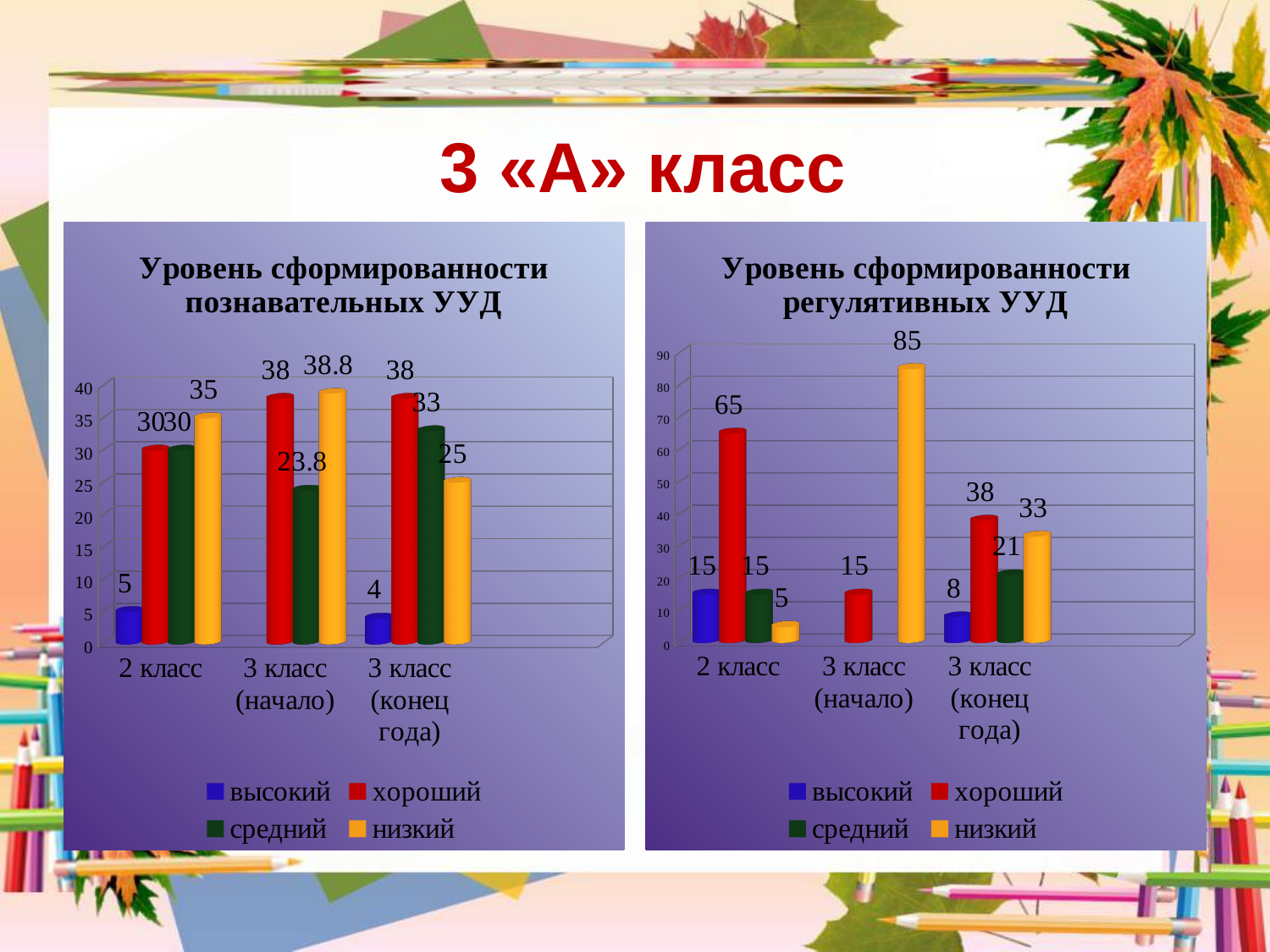
What kind of chart is the chart titled "Уровень сформированности познавательных УУД"? bar chart On the chart titled "Уровень сформированности регулятивных УУД", what is the value for хороший in 2 класс? 65 On the chart titled "Уровень сформированности регулятивных УУД", what is the value for низкий in 3 класс (начало)? 85 On the chart titled "Уровень сформированности познавательных УУД", what is the value for средний in 3 класс (начало)? 23.8 On the chart titled "Уровень сформированности познавательных УУД", what is the value for высокий in 3 класс (конец года)? 4 How many series does the legend list on the chart titled "Уровень сформированности регулятивных УУД"? 4 On the chart titled "Уровень сформированности регулятивных УУД", which is larger in 3 класс (конец года): хороший or низкий? хороший On the chart titled "Уровень сформированности познавательных УУД", what is the difference between хороший and высокий in 2 класс? 25 On the chart titled "Уровень сформированности познавательных УУД", what is the value for низкий in 2 класс? 35 On the chart titled "Уровень сформированности регулятивных УУД", which series has the lowest value in 3 класс (конец года)? высокий On the chart titled "Уровень сформированности познавательных УУД", which series has the highest value in 3 класс (начало)? низкий On the chart titled "Уровень сформированности регулятивных УУД", what is the difference between низкий in 3 класс (начало) and низкий in 2 класс? 80